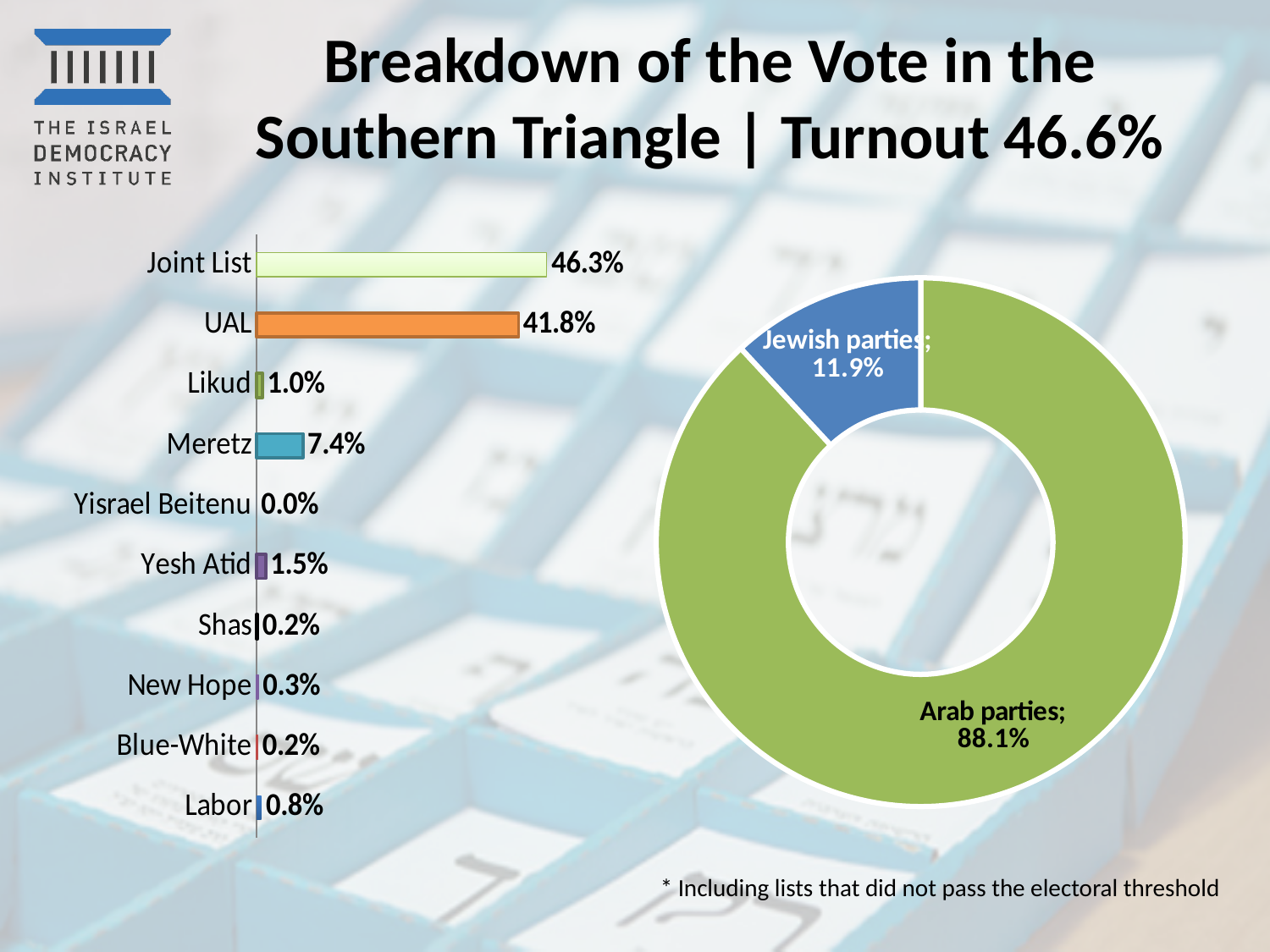
In the bar chart on the left, which is larger, the value for Likud or the value for Yesh Atid? Yesh Atid In the bar chart on the left, what is the difference between the Joint List and UAL values? 4.5% In the bar chart on the left, what is the value for UAL? 41.8% In the doughnut chart on the right, what share do Arab parties have? 88.1% In the bar chart on the left, what is the value for Meretz? 7.4% In the bar chart on the left, what is the value for the Joint List? 46.3% What kind of chart is shown on the left of the slide? Bar chart What turnout figure is given in the slide title? 46.6% In the doughnut chart on the right, what share do Jewish parties have? 11.9% In the bar chart on the left, which party has the highest value? Joint List In the bar chart on the left, which party has the lowest value? Yisrael Beitenu How many parties are listed in the bar chart on the left? 10